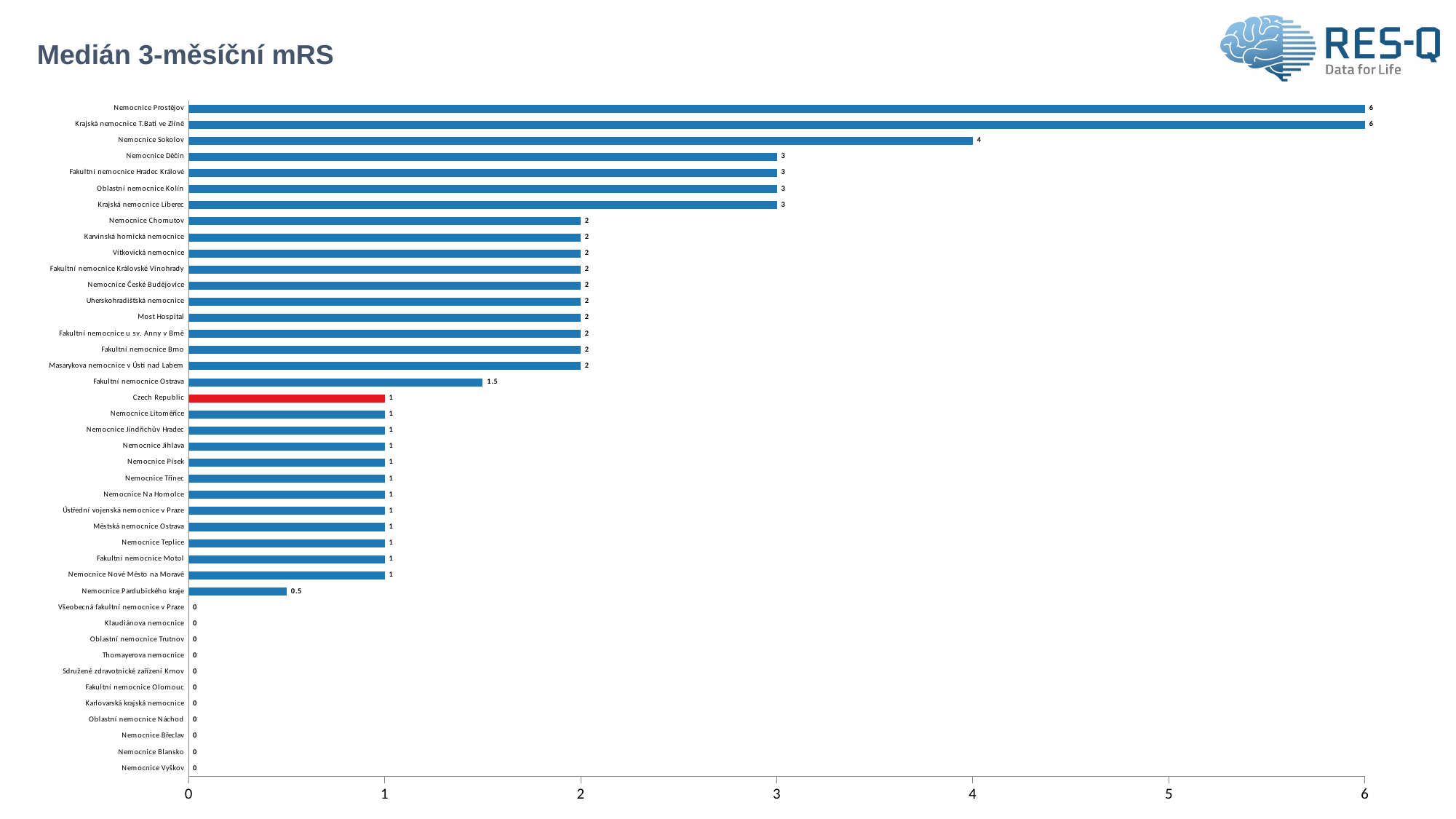
What is the value for Czech Republic? 1 What is the value for Nemocnice Pardubického kraje? 0.5 What is the highest value shown on the chart? 6 What is the value for Nemocnice Děčín? 3 What is the title of the chart? Medián 3-měsíční mRS How many categories are shown on the chart? 42 What kind of chart is shown on the slide? Bar chart What is the value for Fakultní nemocnice Olomouc? 0 What is the difference between the values for Nemocnice Sokolov and Nemocnice Chomutov? 2 What is the value for Nemocnice Sokolov? 4 What is the value for Fakultní nemocnice Ostrava? 1.5 Which has a larger value, Krajská nemocnice Liberec or Fakultní nemocnice Brno? Krajská nemocnice Liberec